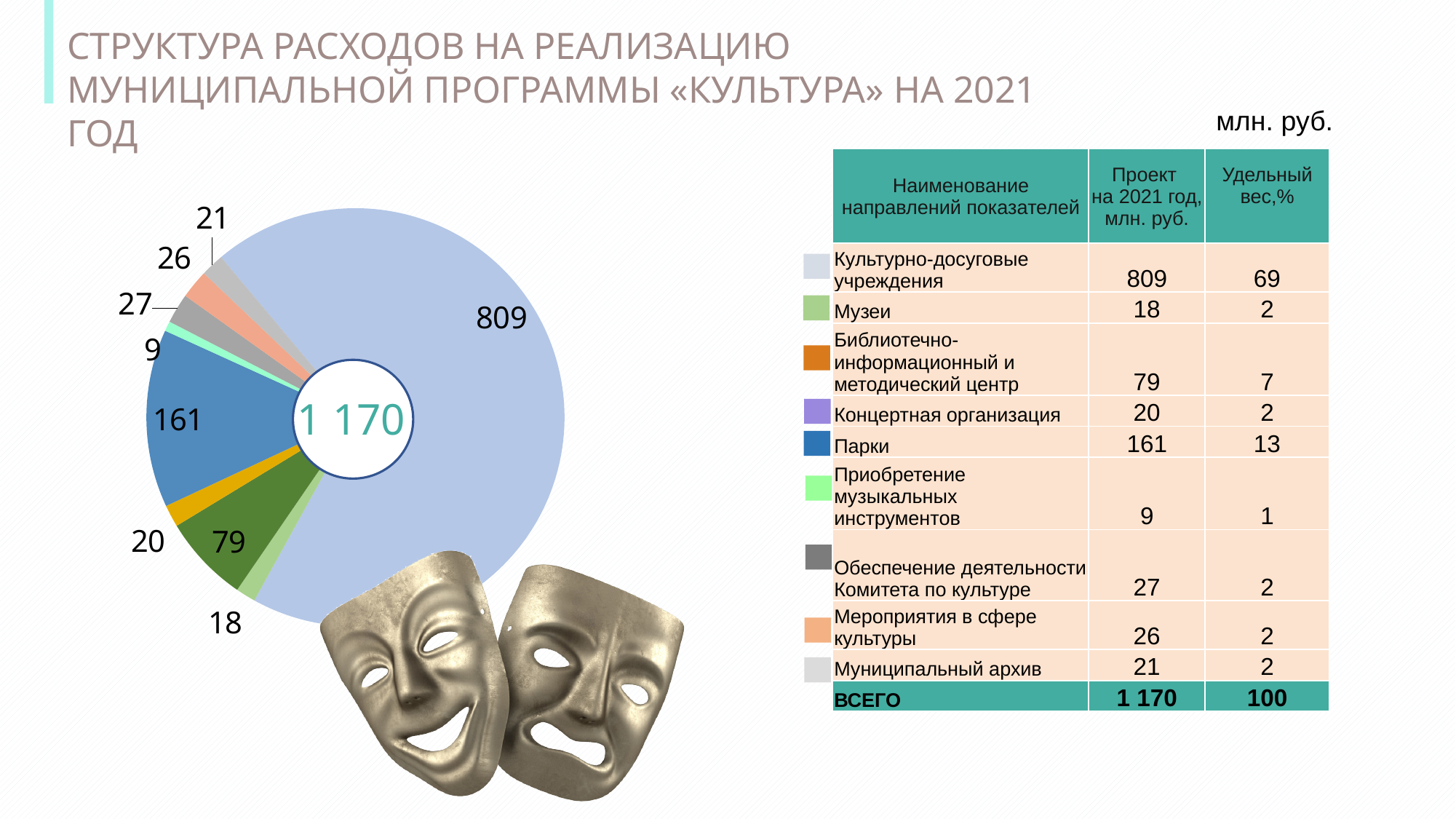
What is the largest value shown on the pie chart? 809 In what units are the values on the pie chart expressed, according to the slide? млн. руб. What value is shown on the pie chart for Парки? 161 What share of the total does the 809 slice (Культурно-досуговые учреждения) represent, according to the slide? 69% What is the difference between the values for Мероприятия в сфере культуры (26) and Муниципальный архив (21)? 5 Which is larger on the pie chart: the slice for Парки (161) or the slice for Библиотечно-информационный и методический центр (79)? Парки What is the difference between the pie chart values 809 and 161? 648 What kind of chart is shown on the slide? pie chart How many slices does the pie chart have? 9 What value is shown on the pie chart for Музеи? 18 What is the smallest value shown on the pie chart? 9 What total value is printed in the centre of the pie chart? 1 170